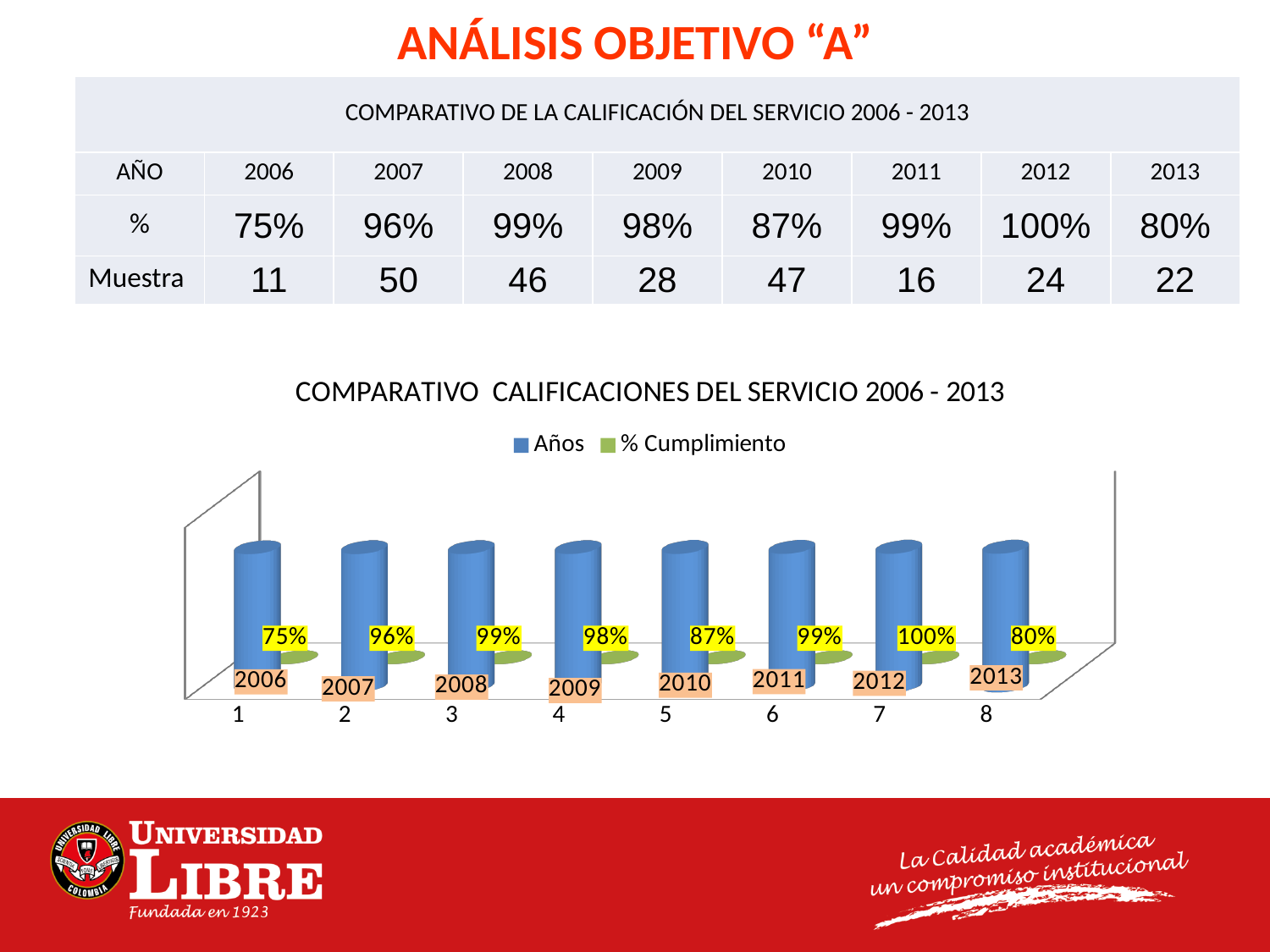
What are the two series named in the chart legend? Años and % Cumplimiento Which has a higher % Cumplimiento, 2009 or 2010? 2009 What is the % Cumplimiento value shown for 2010 in the chart? 87% What is the % Cumplimiento value shown for 2006 in the chart? 75% What is the difference between the % Cumplimiento for 2012 and for 2006? 25% Which year has the lowest % Cumplimiento in the chart? 2006 What is the difference between the % Cumplimiento for 2007 and for 2013? 16% How many years (categories) are plotted in the chart? 8 How many series does the chart legend list? 2 What kind of chart is shown on the slide? Bar chart Which year has the highest % Cumplimiento in the chart? 2012 What is the % Cumplimiento value shown for 2013 in the chart? 80%